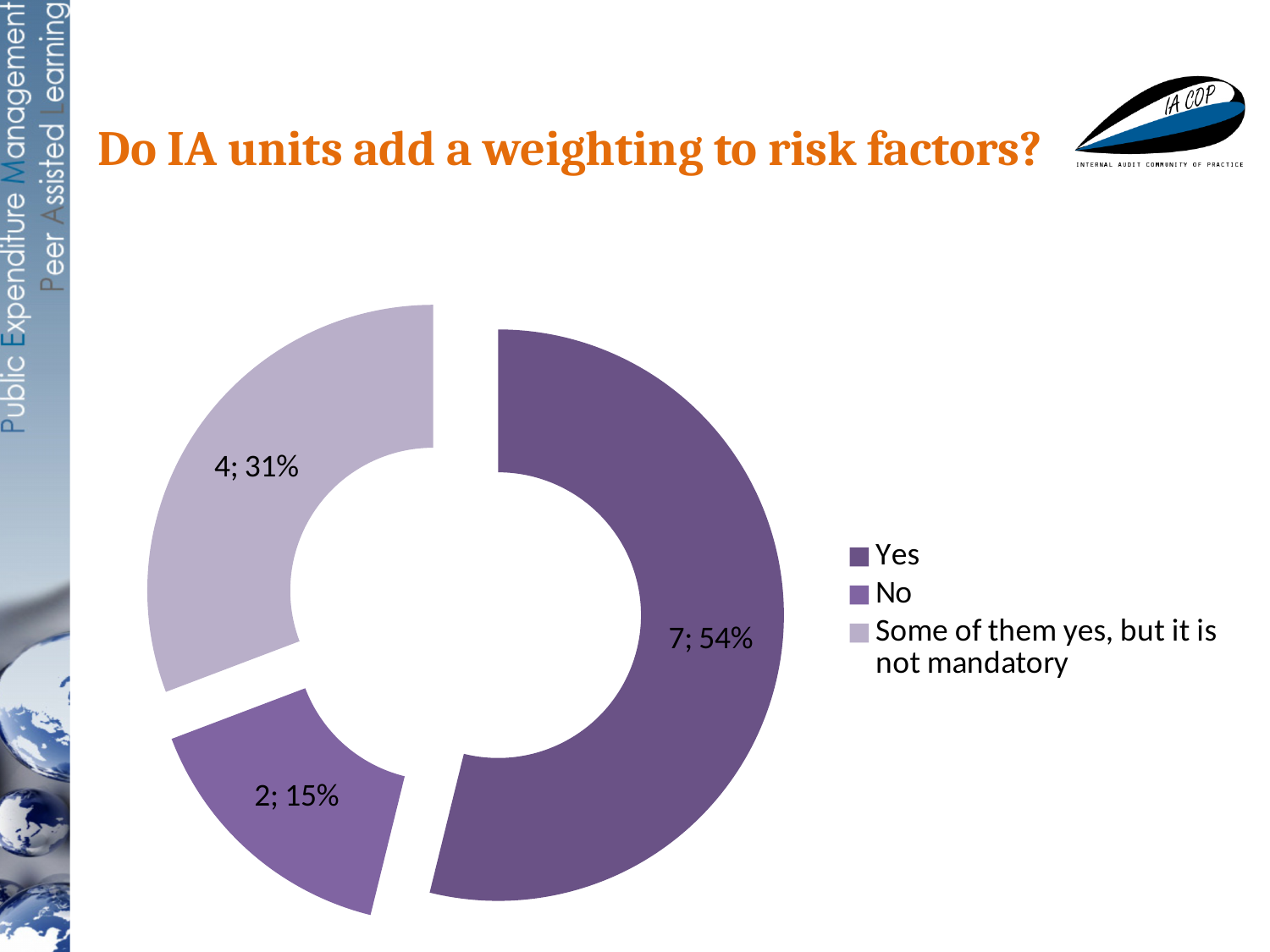
What kind of chart is shown on the slide? Doughnut (pie) chart Which response category has the smallest share? No What percentage of responses is "No"? 15% Which is larger: the share for "No" or the share for "Some of them yes, but it is not mandatory"? Some of them yes, but it is not mandatory How many categories does the chart show? 3 Which response category has the largest share? Yes How many more units answered "Yes" than "No"? 5 What percentage of responses is "Some of them yes, but it is not mandatory"? 31% What is the total number of responses across all categories? 13 How many IA units answered "Yes"? 7 What is the title of the slide containing the chart? Do IA units add a weighting to risk factors? How many IA units answered "Some of them yes, but it is not mandatory"? 4